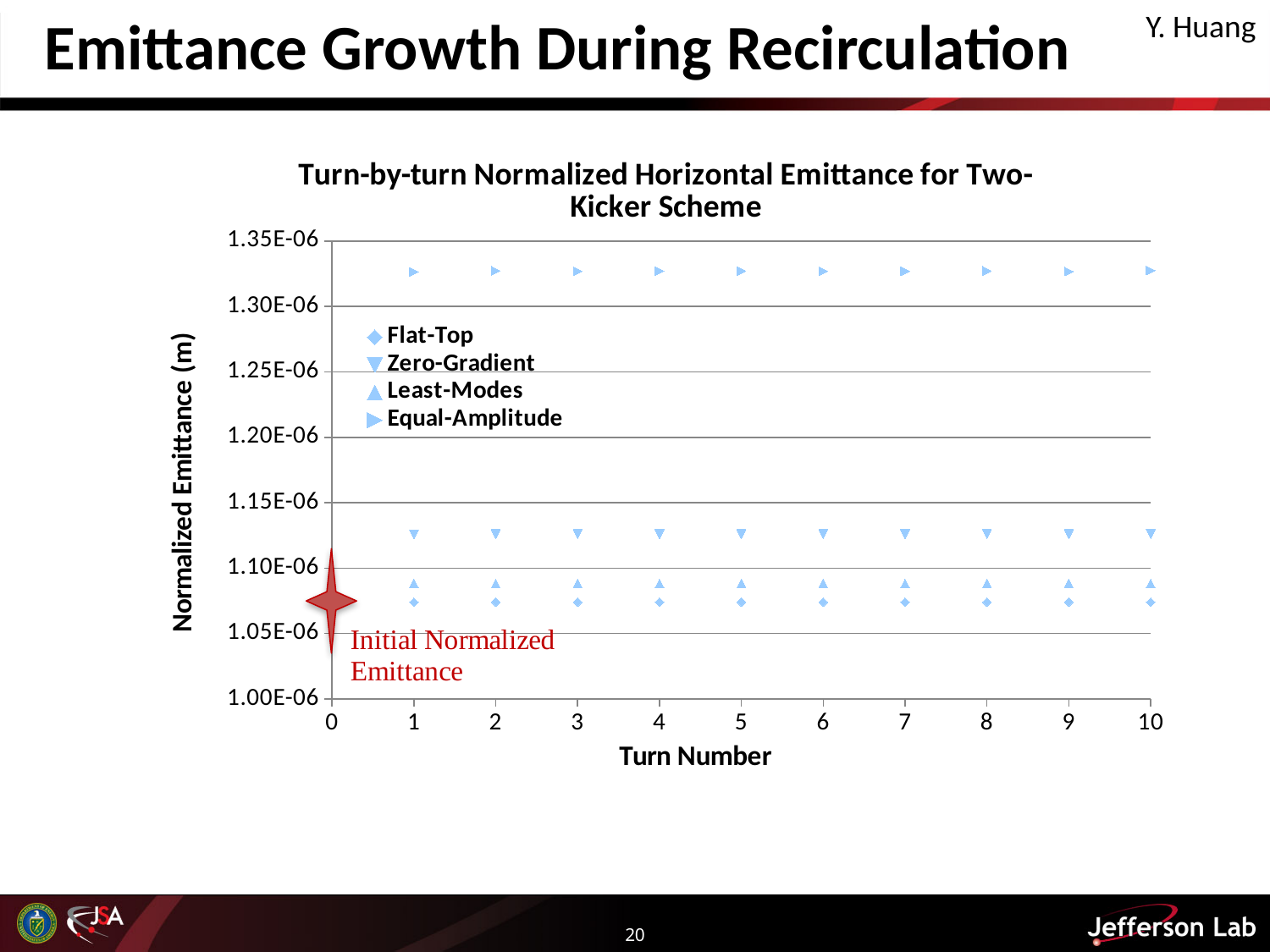
Which series has the highest normalized emittance across the turns? Equal-Amplitude Which series has the lowest normalized emittance across the turns? Flat-Top Is the value for Equal-Amplitude at turn 5 greater or less than 1.30E-06? greater How many series does the legend list? 4 Do the Equal-Amplitude values rise, fall, or stay flat from turn 1 to turn 10? stay flat Is the value for Zero-Gradient at turn 3 greater or less than 1.10E-06? greater What is the title of the chart? Turn-by-turn Normalized Horizontal Emittance for Two-Kicker Scheme What kind of chart is shown on the slide? scatter chart What is the label of the x axis? Turn Number Is the value for Flat-Top at turn 8 greater or less than 1.10E-06? less How many turn numbers have plotted points for each series? 10 Which series has the larger normalized emittance, Zero-Gradient or Least-Modes? Zero-Gradient